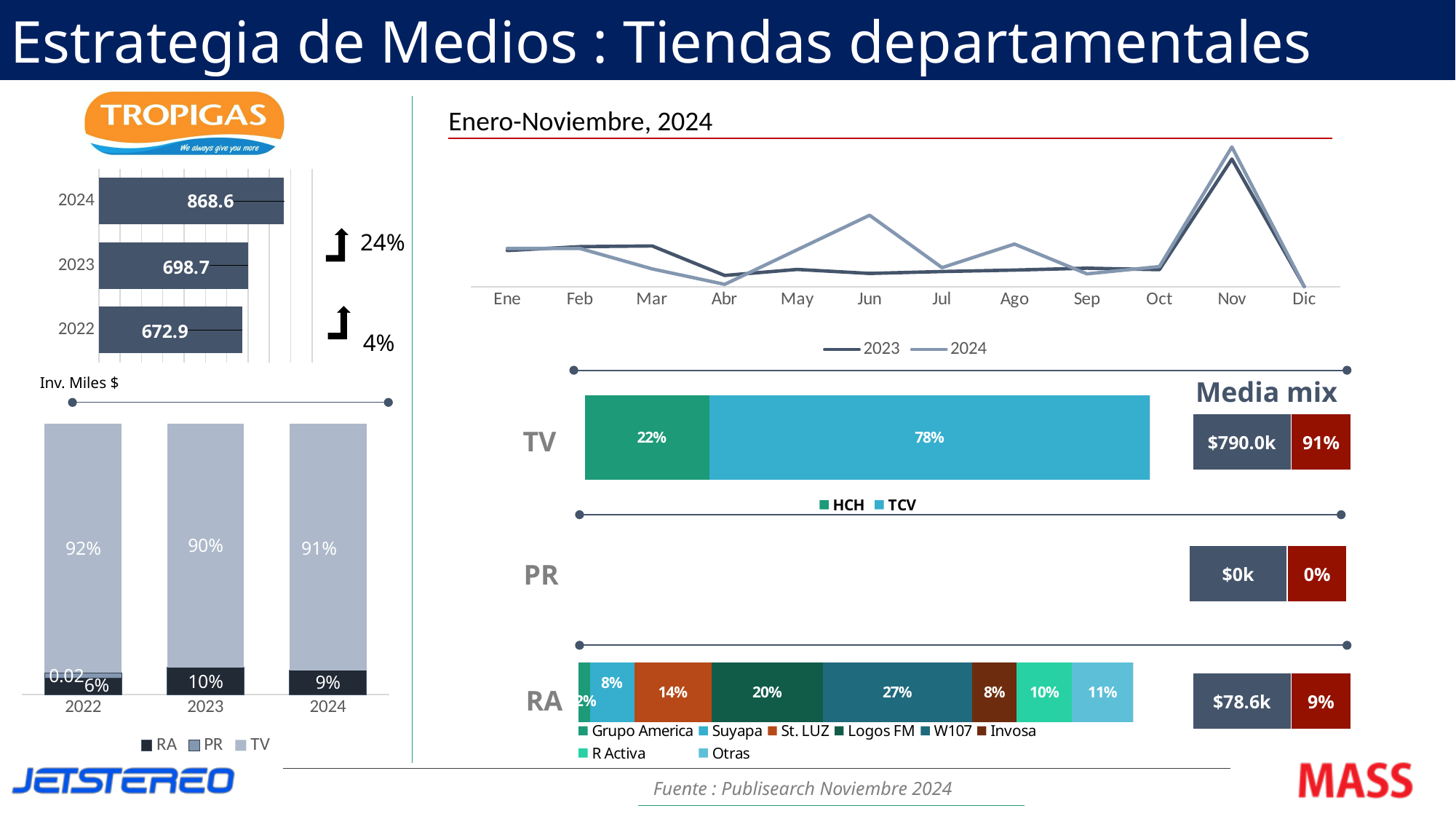
In the TV media mix bar, what is the share for TCV? 78% In the top-left bar chart of investment by year, what is the difference between the 2024 and 2023 values? 169.9 In the RA media mix bar, which station has the largest share? W107 In the top-left bar chart of investment by year, what is the value for 2024? 868.6 In the top-left bar chart of investment by year, what is the value for 2022? 672.9 In the bottom-left stacked bar chart (Inv. Miles $), what is the TV share for 2023? 90% In the bottom-left stacked bar chart (Inv. Miles $), what is the RA share for 2024? 9% In the bottom-left stacked bar chart (Inv. Miles $), how many series does the legend list? 3 In the line chart titled Enero-Noviembre, 2024, in which month does the 2024 line reach its highest point? Nov In the top-left bar chart of investment by year, how many bars are shown? 3 In the top-left bar chart of investment by year, which year has the lowest value? 2022 In the line chart titled Enero-Noviembre, 2024, how many series does the legend list? 2